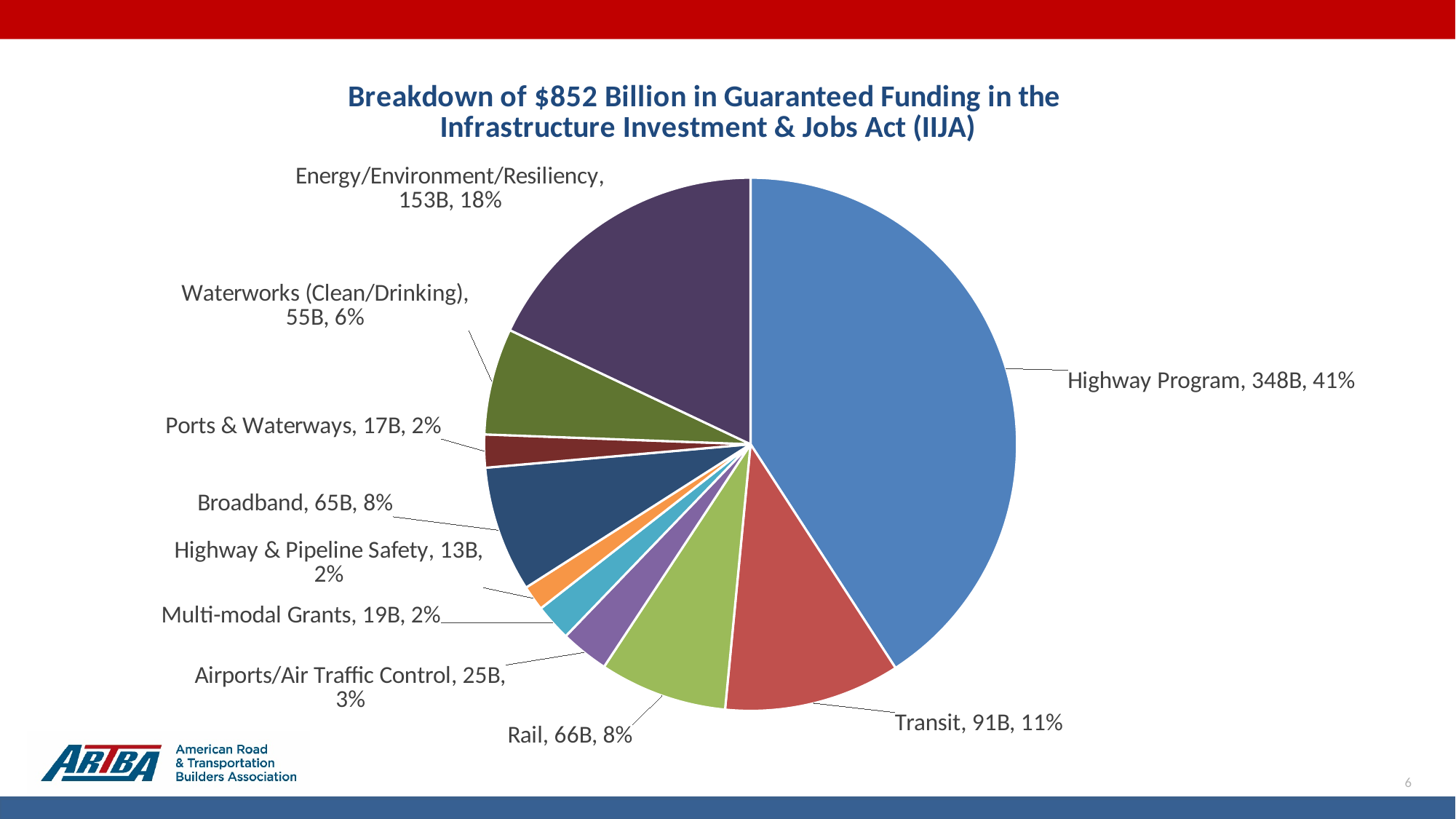
Which receives more funding, Rail or Broadband? Rail What type of chart is shown on the slide? pie chart What share of the pie does Waterworks (Clean/Drinking) represent? 6% What is the difference in funding between the Highway Program and Transit? 257B What is the funding amount for the Highway Program? 348B What share of the pie does Energy/Environment/Resiliency represent? 18% How many categories are shown in the pie chart? 10 What is the difference in funding between Airports/Air Traffic Control and Multi-modal Grants? 6B What is the funding amount for Transit? 91B Which category has the smallest funding amount? Highway & Pipeline Safety Which category has the largest slice of the pie? Highway Program What is the title of the chart? Breakdown of $852 Billion in Guaranteed Funding in the Infrastructure Investment & Jobs Act (IIJA)